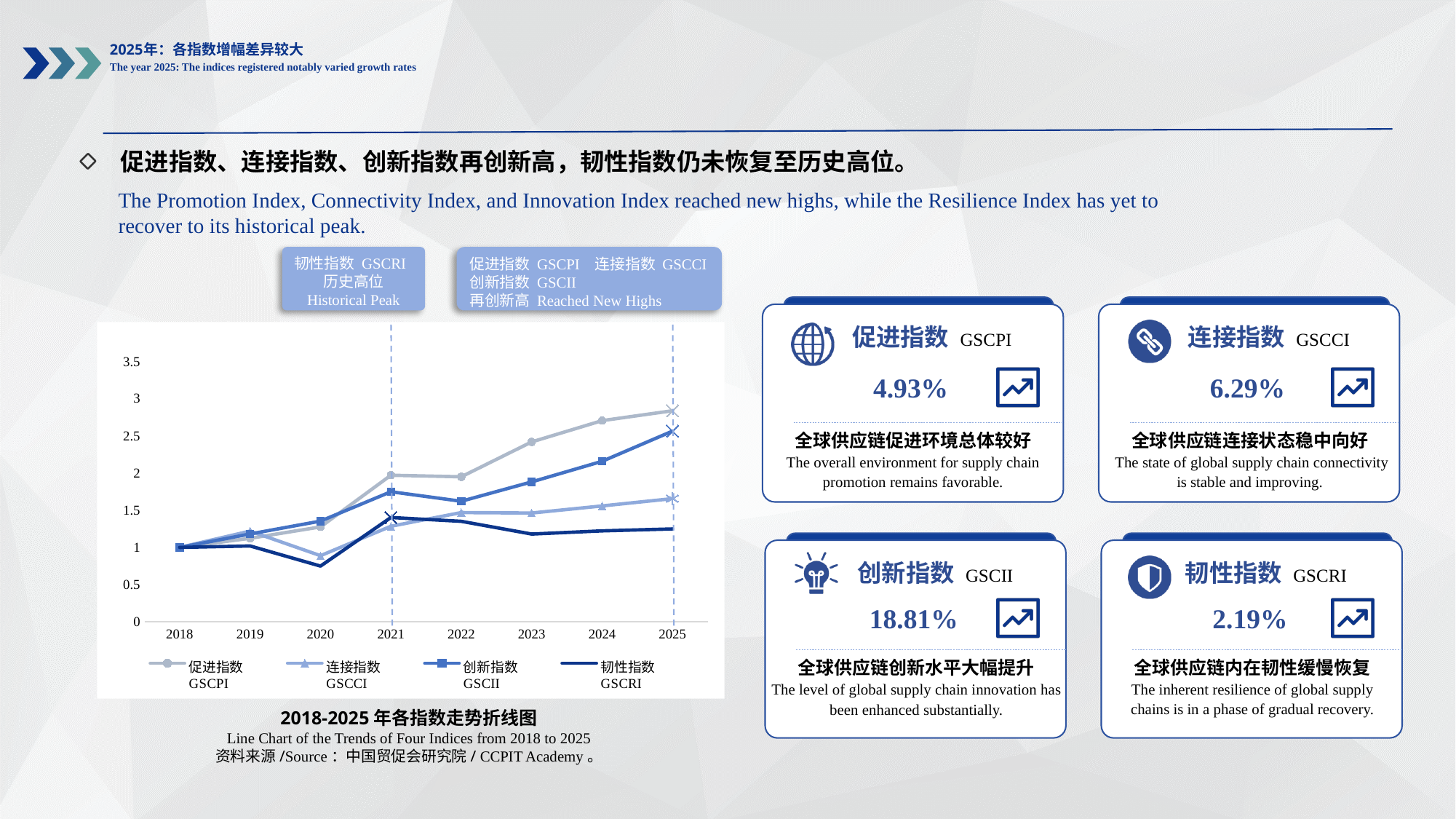
What kind of chart is shown on the slide? line chart What is the English title of the chart? Line Chart of the Trends of Four Indices from 2018 to 2025 How many series does the chart legend list? 4 How many years are plotted along the x axis of the chart? 8 Does the 促进指数 GSCPI series rise or fall overall from 2018 to 2025? rise Which series has the highest value in 2025? 促进指数 GSCPI In 2025, which is larger: the 创新指数 GSCII value or the 连接指数 GSCCI value? 创新指数 GSCII What is the value of the 促进指数 GSCPI series in 2018? 1 Is the value for 韧性指数 GSCRI in 2025 greater or less than 1.5? less Is the value for 连接指数 GSCCI in 2020 greater or less than 1? less Which series has the lowest value in 2025? 韧性指数 GSCRI Is the value for 促进指数 GSCPI in 2025 greater or less than 2.5? greater